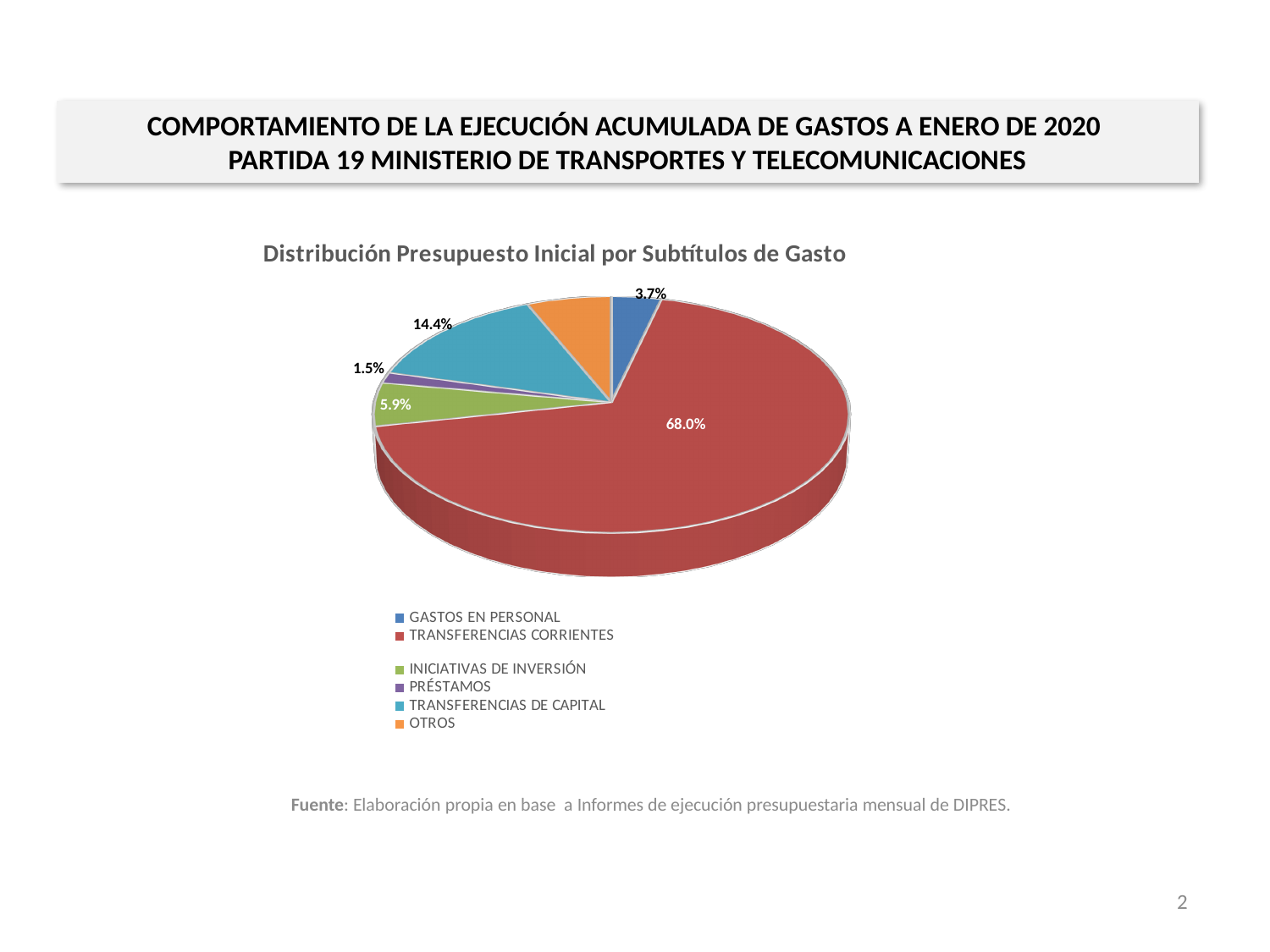
What is the difference in percentage points between TRANSFERENCIAS CORRIENTES and TRANSFERENCIAS DE CAPITAL? 53.6 What percentage is shown for GASTOS EN PERSONAL? 3.7% What percentage is shown for INICIATIVAS DE INVERSIÓN? 5.9% Which is larger, the share for INICIATIVAS DE INVERSIÓN or the share for GASTOS EN PERSONAL? INICIATIVAS DE INVERSIÓN What is the title of the chart? Distribución Presupuesto Inicial por Subtítulos de Gasto Which category has the largest slice of the pie? TRANSFERENCIAS CORRIENTES Which category has the smallest slice of the pie? PRÉSTAMOS What percentage is shown for TRANSFERENCIAS DE CAPITAL? 14.4% What percentage is shown for PRÉSTAMOS? 1.5% How many categories does the legend of the pie chart list? 6 What share of the pie does TRANSFERENCIAS CORRIENTES represent? 68.0% What type of chart is shown on the slide? Pie chart